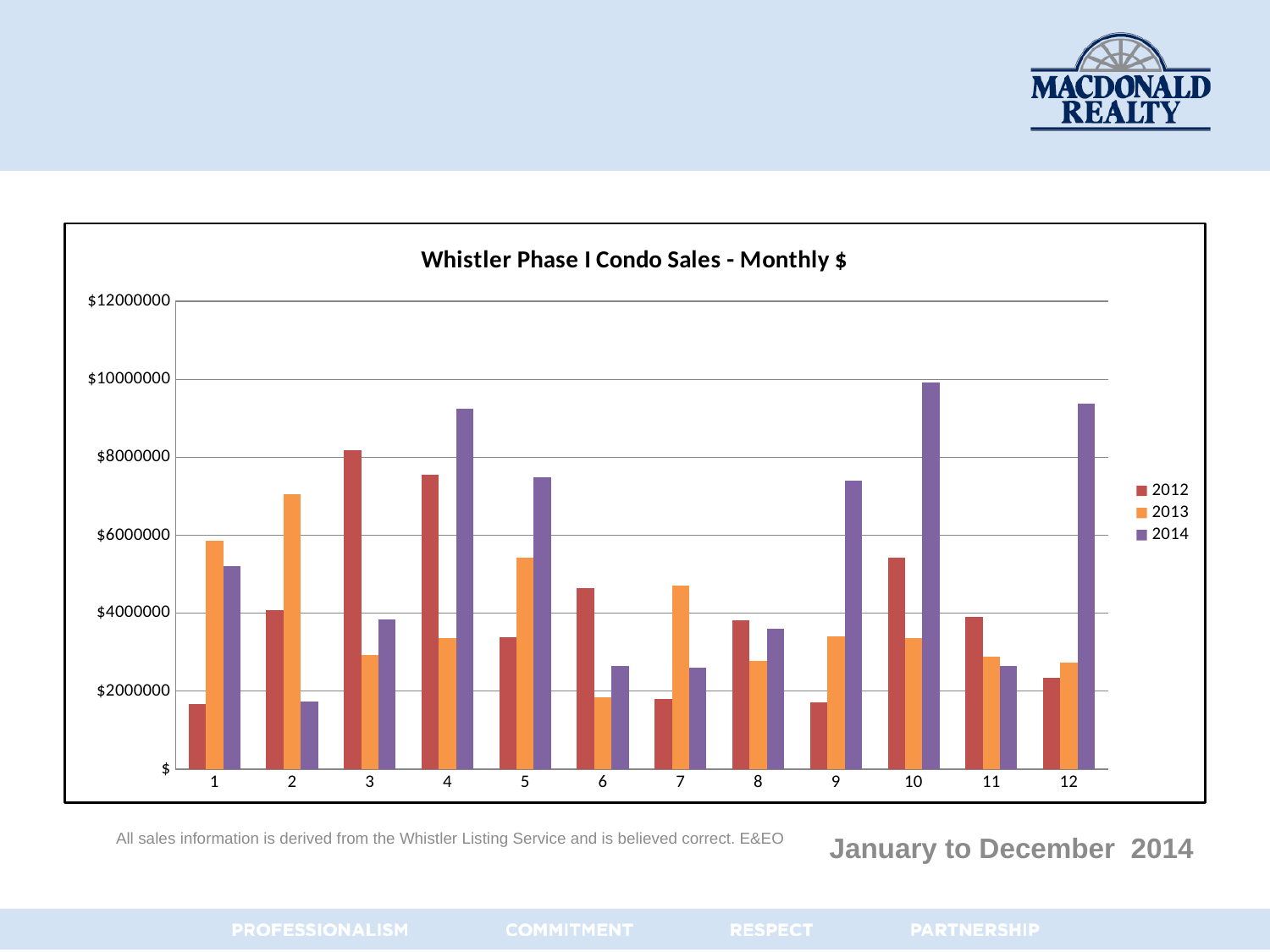
In which month does the 2013 series reach its highest value? 2 In which month does the 2014 series reach its highest value? 10 How many months (categories) are shown on the x axis? 12 How many series does the legend list? 3 In which month does the 2012 series reach its highest value? 3 In month 4, which series has the larger value, 2012 or 2014? 2014 What is the title of the chart? Whistler Phase I Condo Sales - Monthly $ In which month is the 2014 value the lowest? 2 Is the 2014 value for month 10 greater or less than $8000000? greater What kind of chart is shown on the slide? bar chart In month 2, which series has the larger value, 2013 or 2014? 2013 Is the 2013 value for month 6 greater or less than $2000000? less